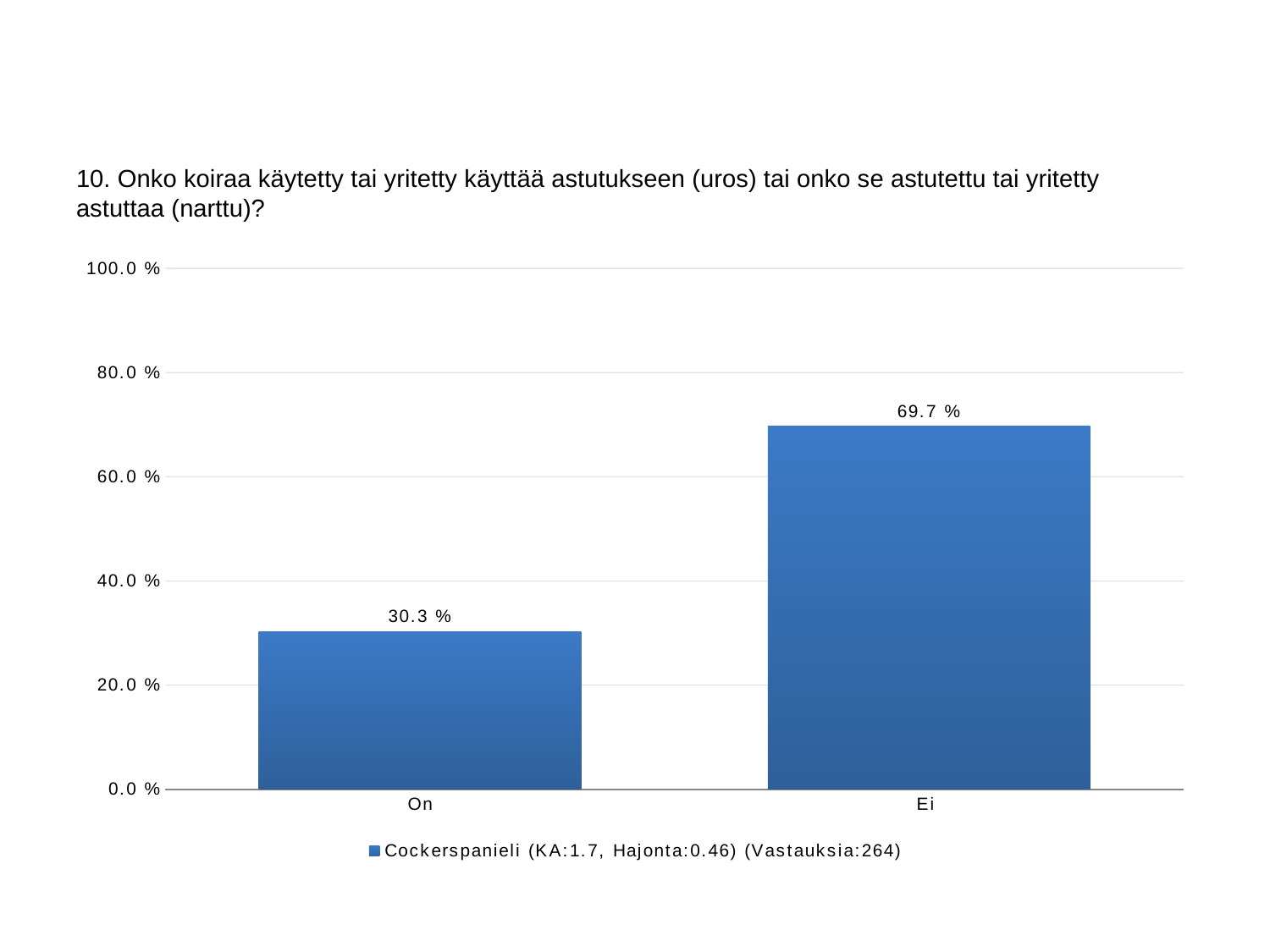
Is the value for "On" greater or less than 40.0 %? less How many responses (Vastauksia) does the legend entry report? 264 Which is larger, the value for "On" or the value for "Ei"? Ei Is the value for "Ei" greater or less than 60.0 %? greater What is the difference between the values for "Ei" and "On"? 39.4 % What kind of chart is shown on the slide? Bar chart How many categories are shown on the x axis? 2 What is the value for "On"? 30.3 % Which category has the lowest value? On What is the value for "Ei"? 69.7 % Which category has the highest value? Ei How many series does the legend list? 1